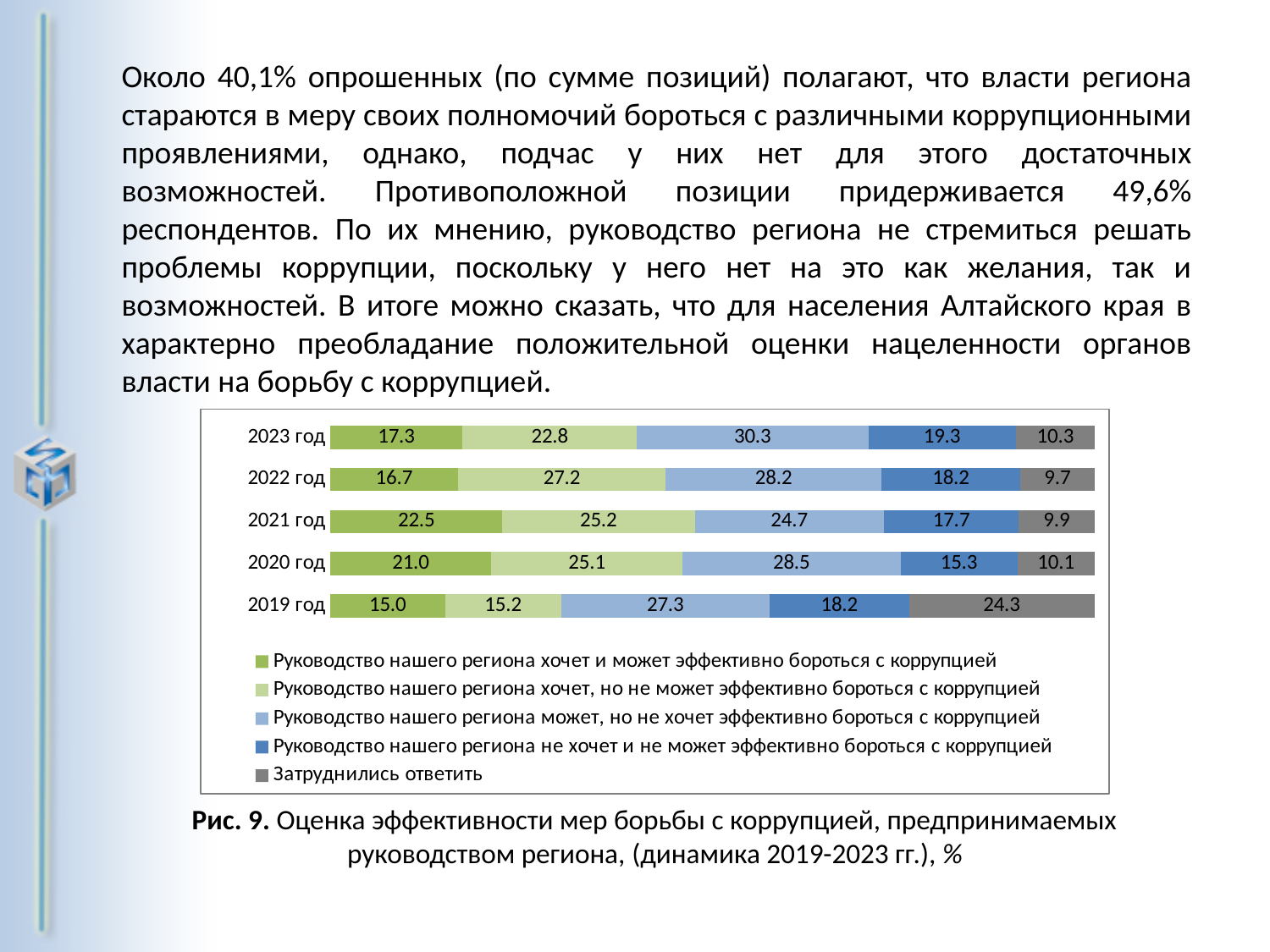
What is the value for 'Руководство нашего региона может, но не хочет эффективно бороться с коррупцией' in 2020 год? 28.5 What is the difference between the 'Руководство нашего региона хочет, но не может эффективно бороться с коррупцией' values for 2022 год and 2019 год? 12.0 In which year is the value for 'Затруднились ответить' the lowest? 2022 год How many series does the legend list? 5 In which year is the value for 'Руководство нашего региона хочет и может эффективно бороться с коррупцией' the highest? 2021 год How many years (categories) are plotted in the chart? 5 Which colour represents 'Затруднились ответить' in the chart? grey What is the total of the stacked bar for 2023 год? 100.0 Which is larger: the 'Руководство нашего региона не хочет и не может эффективно бороться с коррупцией' value in 2023 год or in 2020 год? 2023 год What is the value for 'Руководство нашего региона хочет и может эффективно бороться с коррупцией' in 2023 год? 17.3 What is the value for 'Затруднились ответить' in 2019 год? 24.3 What kind of chart is shown on the slide? stacked bar chart